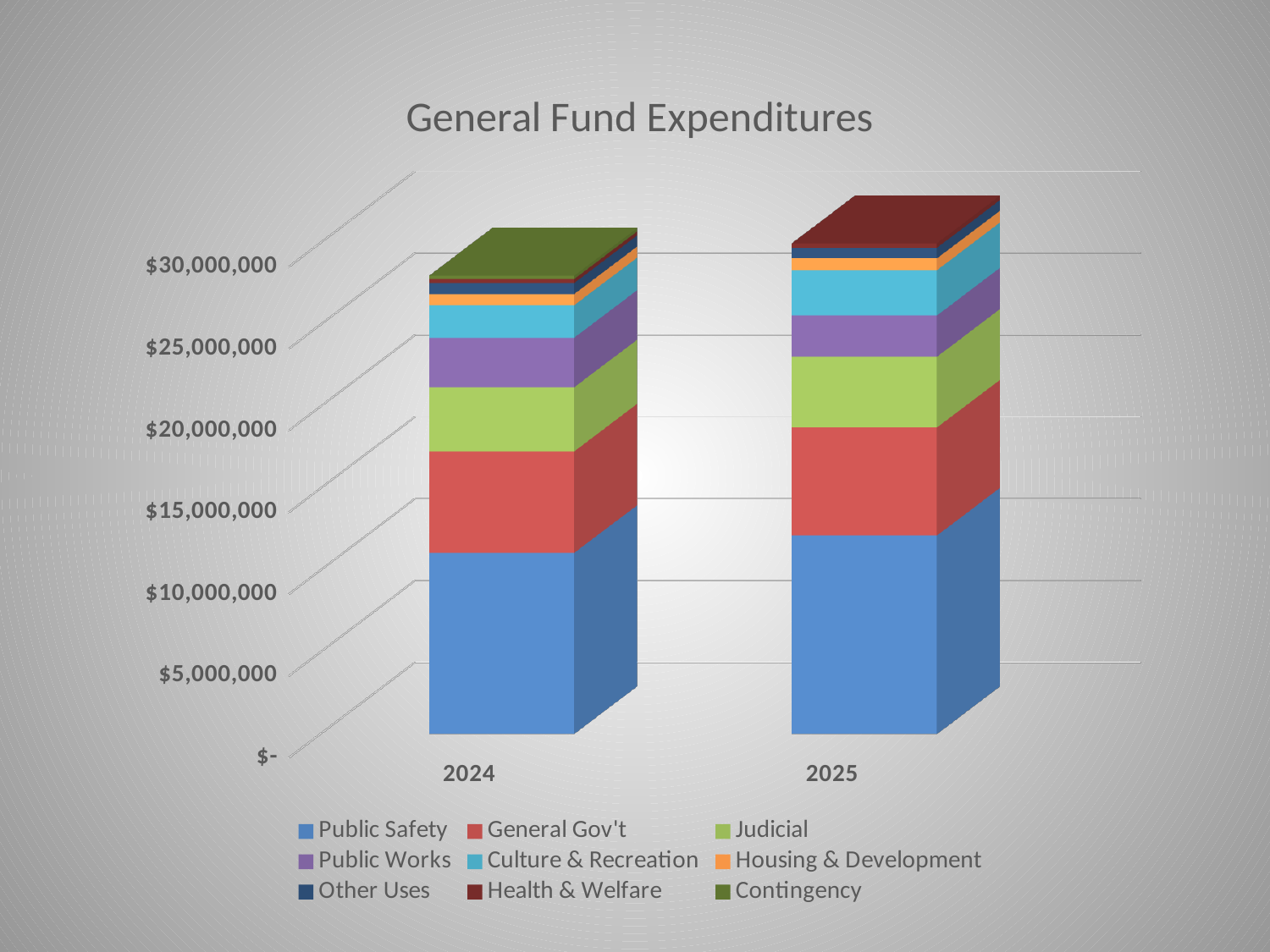
Which legend series appears in the 2024 bar but not in the 2025 bar? Contingency What kind of chart is shown on the slide? Stacked bar chart Is the Public Safety segment larger in 2024 or in 2025? 2025 Is the value for General Gov't in 2024 greater or less than $10,000,000? less Which series is the largest segment of the 2024 bar? Public Safety How many series does the legend list? 9 Do total General Fund Expenditures rise or fall from 2024 to 2025? Rise Which year has the taller total bar, 2024 or 2025? 2025 What is the title of the chart? General Fund Expenditures How many years (categories) are plotted on the x axis? 2 Is the value for Public Safety in 2024 greater or less than $10,000,000? greater